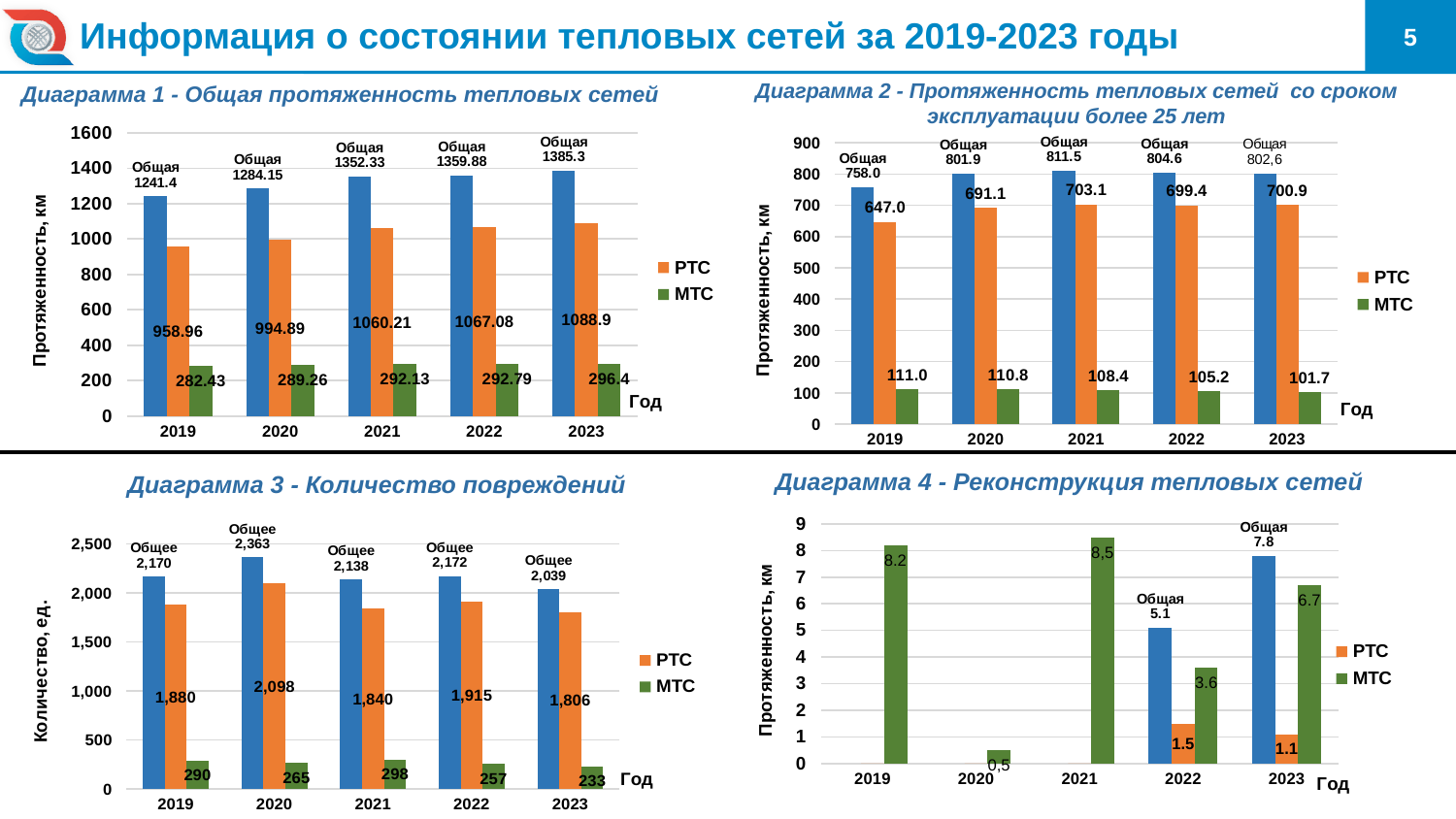
In Диаграмма 4 - Реконструкция тепловых сетей, which year has the lowest МТС value? 2020 In Диаграмма 4 - Реконструкция тепловых сетей, what is the МТС value for 2021? 8,5 In Диаграмма 1 - Общая протяженность тепловых сетей, what is the difference between the РТС values for 2023 and 2019? 129.94 In Диаграмма 3 - Количество повреждений, what is the total (Общее) value for 2022? 2,172 In Диаграмма 2 - Протяженность тепловых сетей со сроком эксплуатации более 25 лет, what is the МТС value for 2022? 105.2 In Диаграмма 1 - Общая протяженность тепловых сетей, which year has the highest МТС value? 2023 In Диаграмма 2 - Протяженность тепловых сетей со сроком эксплуатации более 25 лет, do the МТС values rise or fall from 2019 to 2023? fall In Диаграмма 3 - Количество повреждений, which is larger: the МТС value for 2021 or for 2023? 2021 How many series does the legend of Диаграмма 4 - Реконструкция тепловых сетей list? 2 In Диаграмма 2 - Протяженность тепловых сетей со сроком эксплуатации более 25 лет, which year has the lowest РТС value? 2019 In Диаграмма 3 - Количество повреждений, what is the РТС value for 2020? 2,098 In Диаграмма 1 - Общая протяженность тепловых сетей, what is the РТС value for 2021? 1060.21